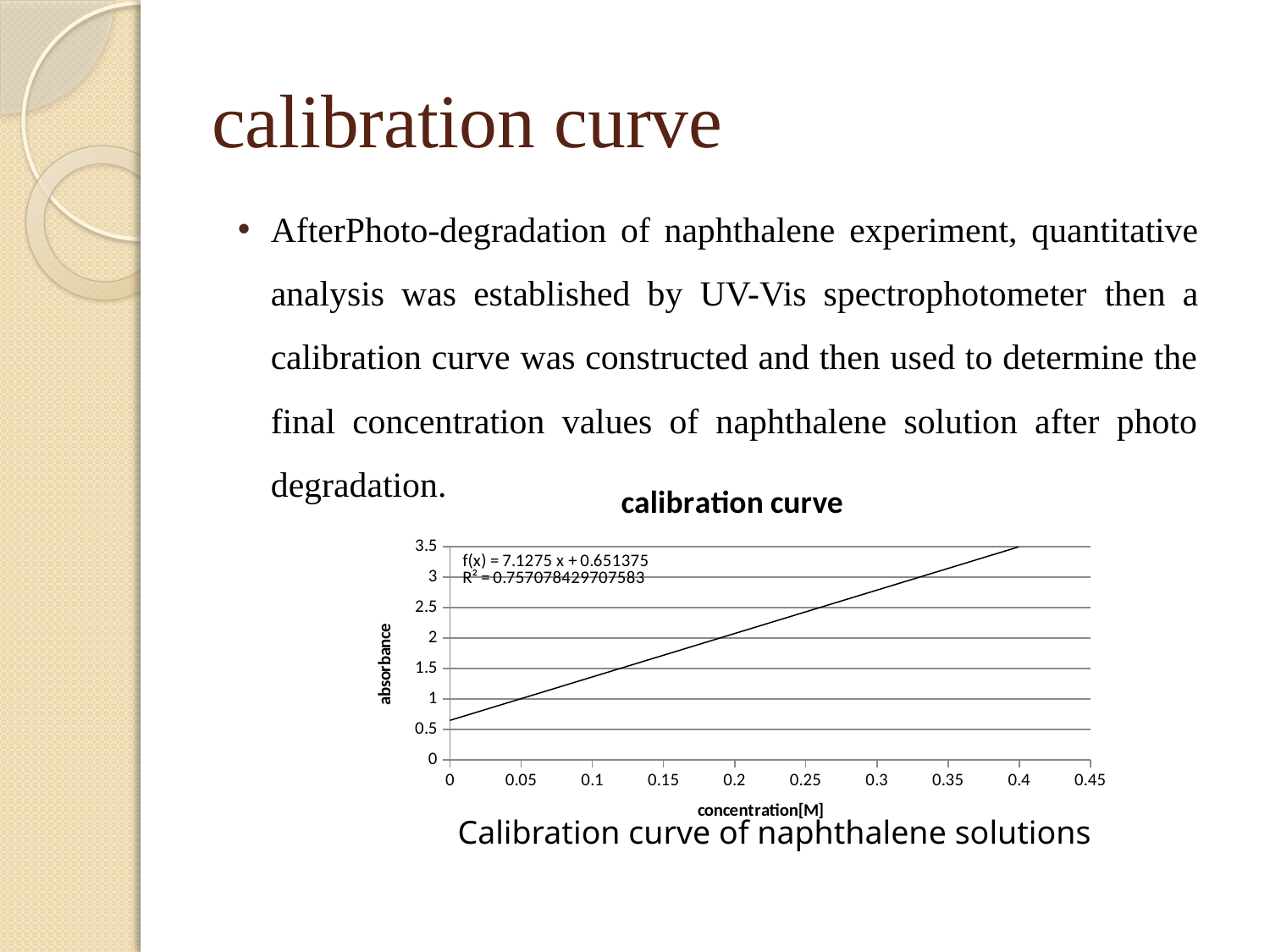
What is the highest value shown on the x axis of the chart? 0.45 What kind of chart is shown on the slide? line chart What is the title of the chart? calibration curve What is the label of the x axis of the chart? concentration[M] What is the trendline equation printed on the chart? f(x) = 7.1275 x + 0.651375 Is the absorbance value on the line at a concentration of 0.4 greater or less than 3? greater Is the absorbance value on the line at a concentration of 0.3 greater or less than 3? less Does the absorbance rise or fall as concentration increases along the x axis? rise What R² value is printed on the chart? 0.757078429707583 Is the absorbance value on the line at a concentration of 0.1 greater or less than 1? greater What is the highest value shown on the y axis of the chart? 3.5